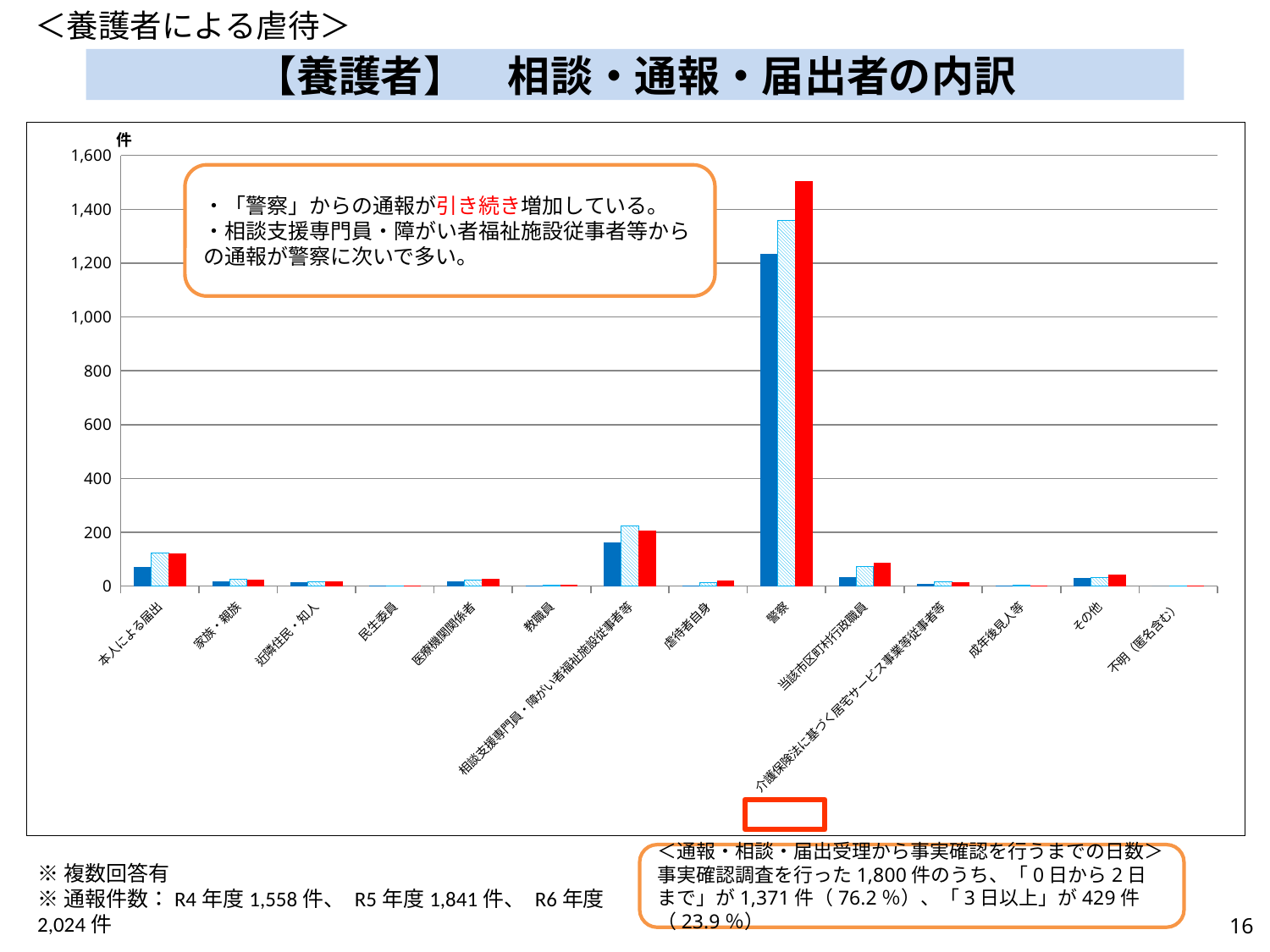
Is the value of the red bar for 相談支援専門員・障がい者福祉施設従事者等 greater or less than 400? less Which category has larger values, 相談支援専門員・障がい者福祉施設従事者等 or 家族・親族? 相談支援専門員・障がい者福祉施設従事者等 Is the value of the solid blue bar for 警察 greater or less than 1,200? greater Is the value of the red bar for 本人による届出 greater or less than 200? less For the 警察 category, do the three bars rise or fall from left to right? rise How many categories are shown along the x axis of the chart? 14 Which category has larger values, 警察 or 本人による届出? 警察 What unit is shown at the top of the y axis of the chart? 件 What kind of chart is shown on the slide? bar chart How many bars are plotted for each category in the chart? 3 Which category has the highest values in the chart? 警察